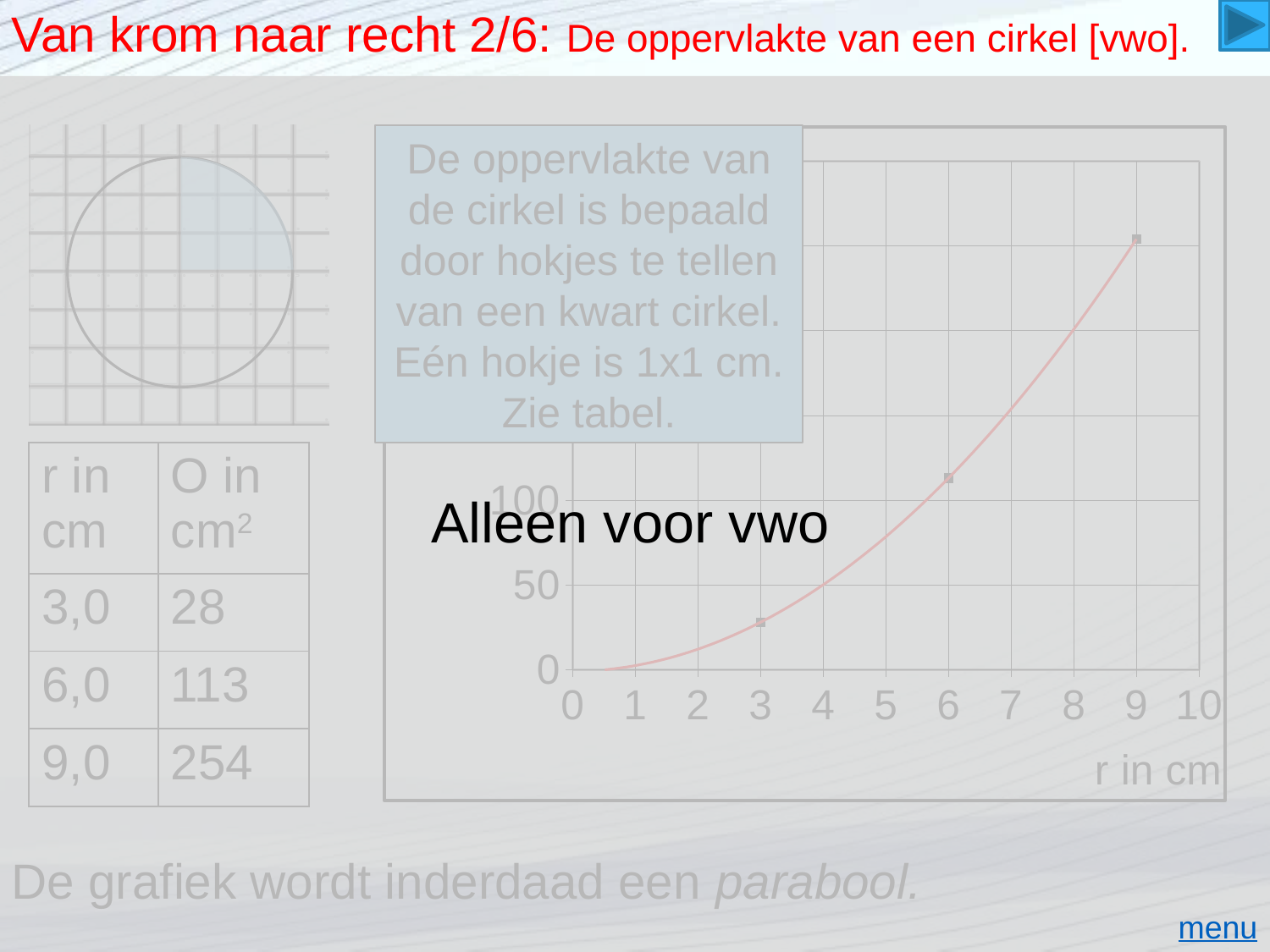
Is the plotted value at r = 3 greater or less than 50? less How many data points are plotted on the chart? 3 According to the table on the slide, what is the value of O for r = 9,0 cm? 254 What is the label of the x axis of the chart? r in cm Is the plotted value at r = 9 greater or less than 100? greater Do the plotted values rise or fall as r increases along the x axis? rise Is the plotted value at r = 6 greater or less than 100? greater Which plotted point is higher, the one at r = 6 or the one at r = 3? r = 6 At which value of r is the plotted point lowest? 3 According to the table on the slide, what is the value of O for r = 6,0 cm? 113 What kind of chart is shown on the right of the slide? line chart At which value of r is the plotted point highest? 9